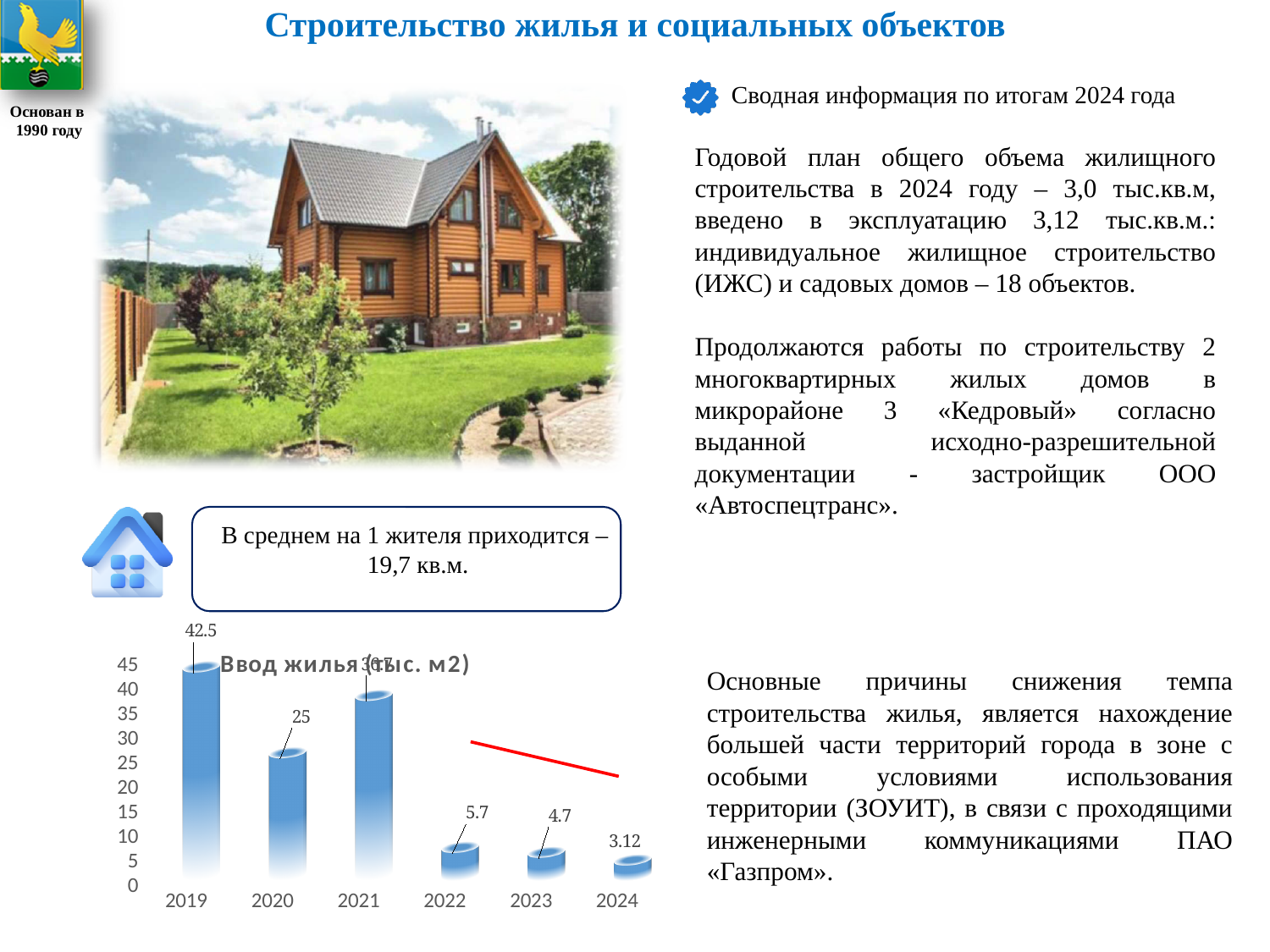
Which year has the highest value in the chart "Ввод жилья (тыс. м2)"? 2019 What is the value for 2023 in the chart "Ввод жилья (тыс. м2)"? 4.7 What is the value for 2020 in the chart "Ввод жилья (тыс. м2)"? 25 In the chart "Ввод жилья (тыс. м2)", which is larger: the value for 2020 or the value for 2022? 2020 What kind of chart is "Ввод жилья (тыс. м2)"? bar chart In the chart "Ввод жилья (тыс. м2)", what is the difference between the values for 2019 and 2020? 17.5 In the chart "Ввод жилья (тыс. м2)", is the value for 2021 greater or less than 35? greater What is the value for 2022 in the chart "Ввод жилья (тыс. м2)"? 5.7 How many years are shown on the x axis of the chart "Ввод жилья (тыс. м2)"? 6 What is the value for 2019 in the chart "Ввод жилья (тыс. м2)"? 42.5 What is the value for 2024 in the chart "Ввод жилья (тыс. м2)"? 3.12 Which year has the lowest value in the chart "Ввод жилья (тыс. м2)"? 2024